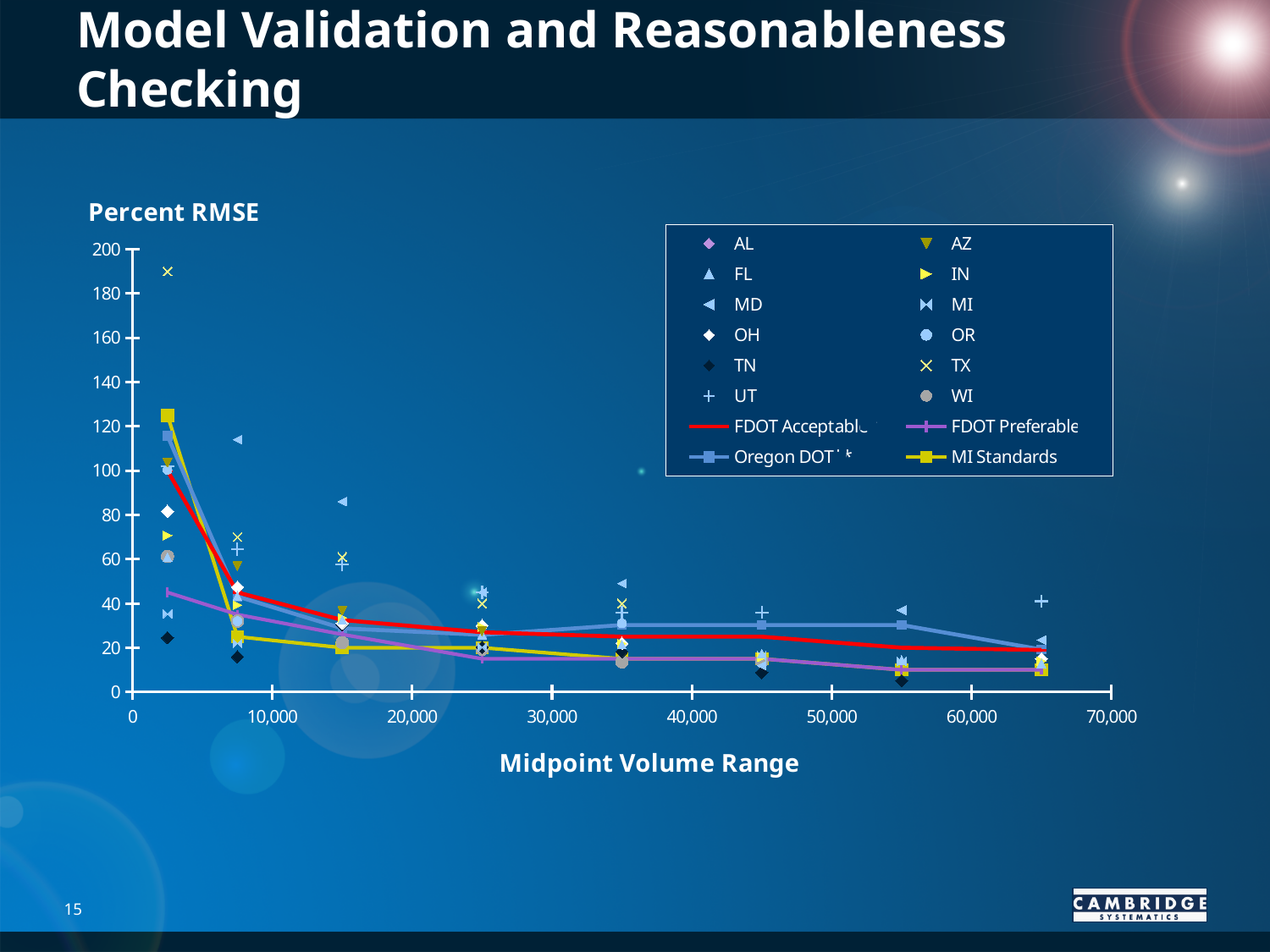
Is the value for MD at the volume range near 7,500 greater or less than 100? greater What is the title of the horizontal axis of the chart? Midpoint Volume Range How many series does the chart's legend list? 16 Does the FDOT Acceptable line rise or fall as the Midpoint Volume Range increases? fall Is the first point of the MI Standards line greater or less than 100? greater What is the title of the vertical axis of the chart? Percent RMSE Does the MI Standards line rise or fall as the Midpoint Volume Range increases? fall Which series has the highest plotted value on the chart? TX At the lowest volume range (near 2,500), which is larger, the value for TX or the value for TN? TX Is the value for UT at the volume range near 65,000 greater or less than 20? greater